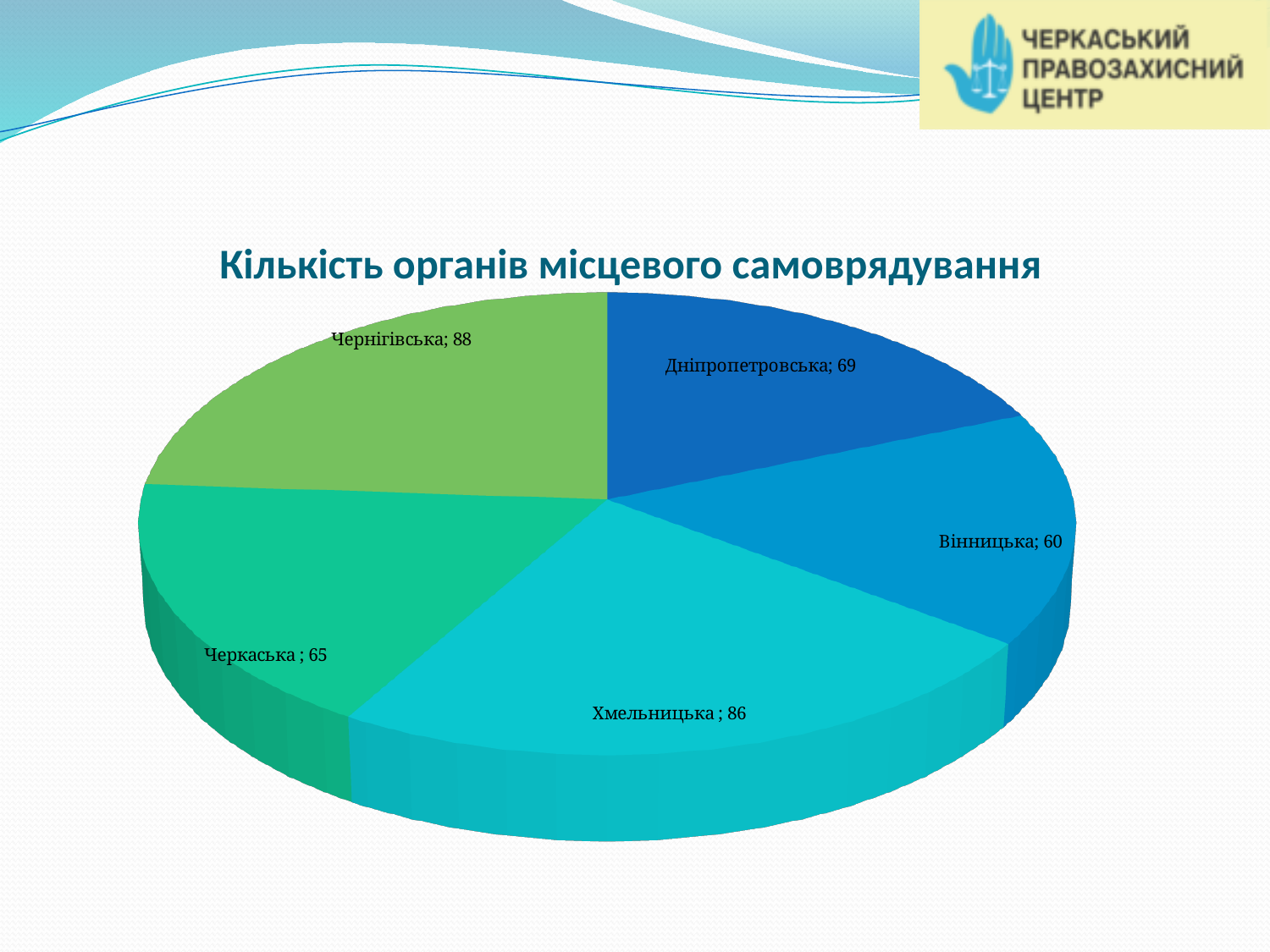
How many regions are shown in the chart? 5 What is the title of the chart? Кількість органів місцевого самоврядування Which region has the lowest value? Вінницька Which is larger, the value for Дніпропетровська or the value for Вінницька? Дніпропетровська What is the difference between the values for Хмельницька and Черкаська? 21 What is the value for Хмельницька? 86 Which region has the highest value? Чернігівська What is the value for Дніпропетровська? 69 What is the value for Черкаська? 65 What is the value for Вінницька? 60 What is the difference between the values for Чернігівська and Вінницька? 28 What kind of chart is shown on the slide? Pie chart